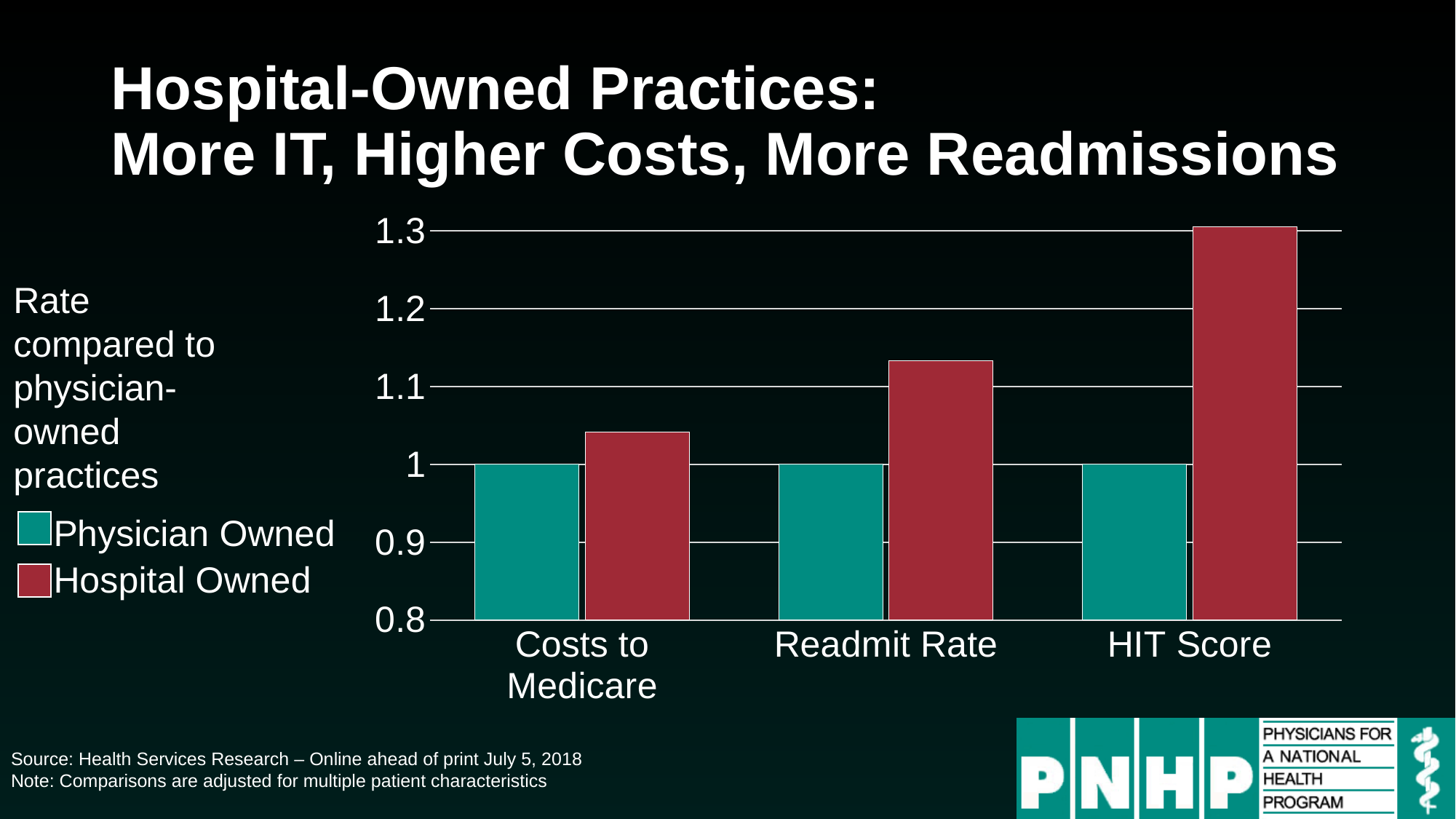
Which category has the lowest Hospital Owned value? Costs to Medicare What kind of chart is shown on the slide? bar chart How many categories are shown on the x axis of the chart? 3 Do the Hospital Owned values rise or fall moving from Costs to Medicare to HIT Score along the x axis? rise How many series does the chart's legend list? 2 Is the Hospital Owned value for Readmit Rate greater or less than 1.1? greater Which category has the highest Hospital Owned value? HIT Score What is the value for Physician Owned in the HIT Score category? 1 Is the Hospital Owned value for Costs to Medicare greater or less than 1.1? less What is the value for Physician Owned in the Readmit Rate category? 1 Is the Hospital Owned value for HIT Score greater or less than 1.2? greater In the Readmit Rate category, which series has the larger value, Physician Owned or Hospital Owned? Hospital Owned